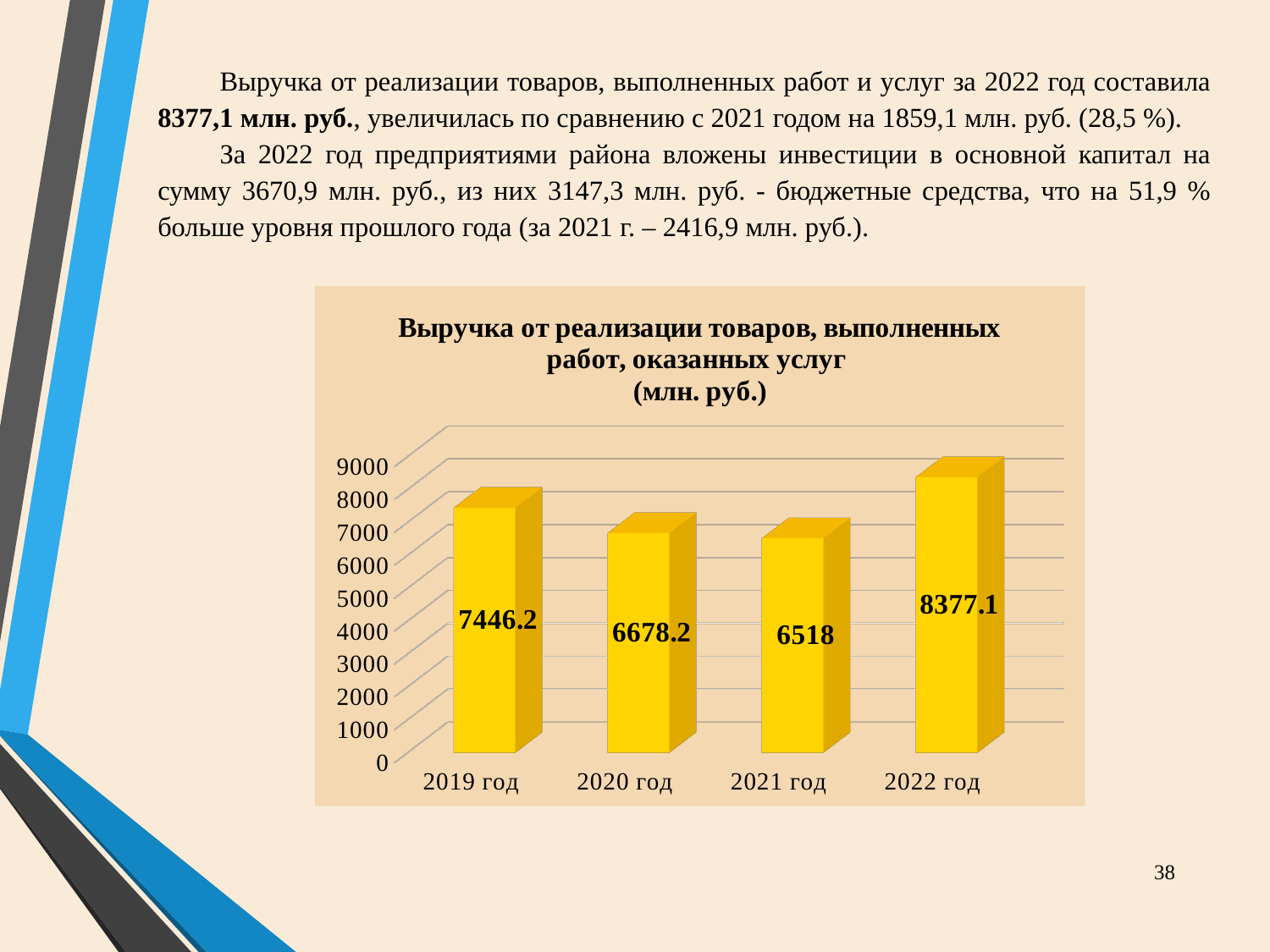
What is the difference between the values for 2019 год and 2020 год? 768 What is the difference between the values for 2022 год and 2021 год? 1859.1 How many years are shown on the chart? 4 Which year has the lowest value? 2021 год What is the title of the chart? Выручка от реализации товаров, выполненных работ, оказанных услуг (млн. руб.) What is the value for 2021 год? 6518 What is the value for 2022 год? 8377.1 What kind of chart is shown on the slide? bar chart Which year has the highest value? 2022 год Is the value for 2022 год greater or less than 8000? greater What is the value for 2019 год? 7446.2 Which is larger, the value for 2019 год or the value for 2020 год? 2019 год